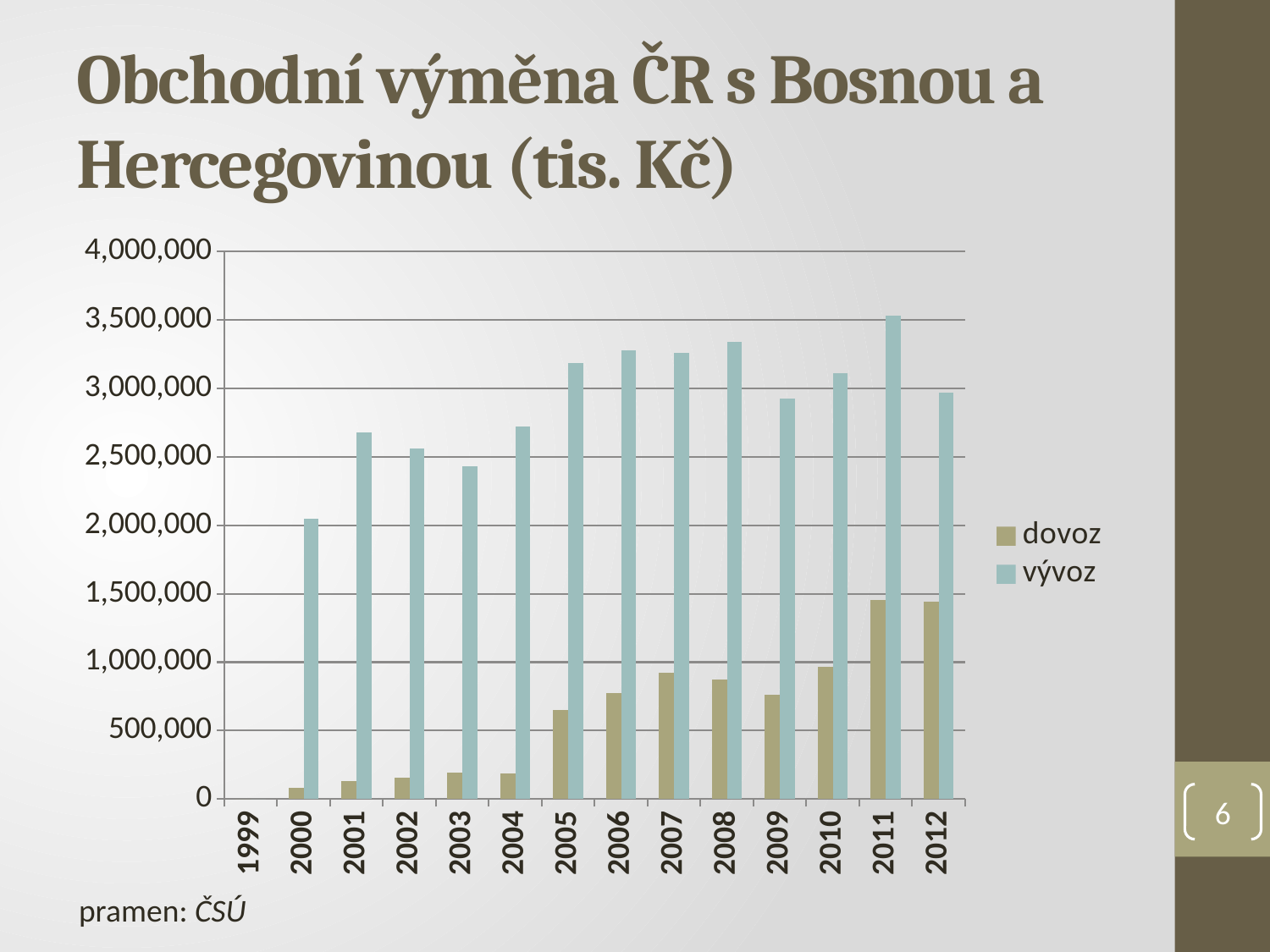
Is the vývoz value for 2005 greater or less than 3,000,000? greater What kind of chart is shown on the slide? bar chart What are the two series named in the legend? dovoz and vývoz Does the dovoz series generally rise or fall from 2000 to 2012? rise How many series does the legend list? 2 How many year labels appear on the x axis? 14 Which is larger, the vývoz value for 2008 or for 2009? 2008 In which year is the vývoz value highest? 2011 Is the vývoz value for 2009 greater or less than 3,000,000? less